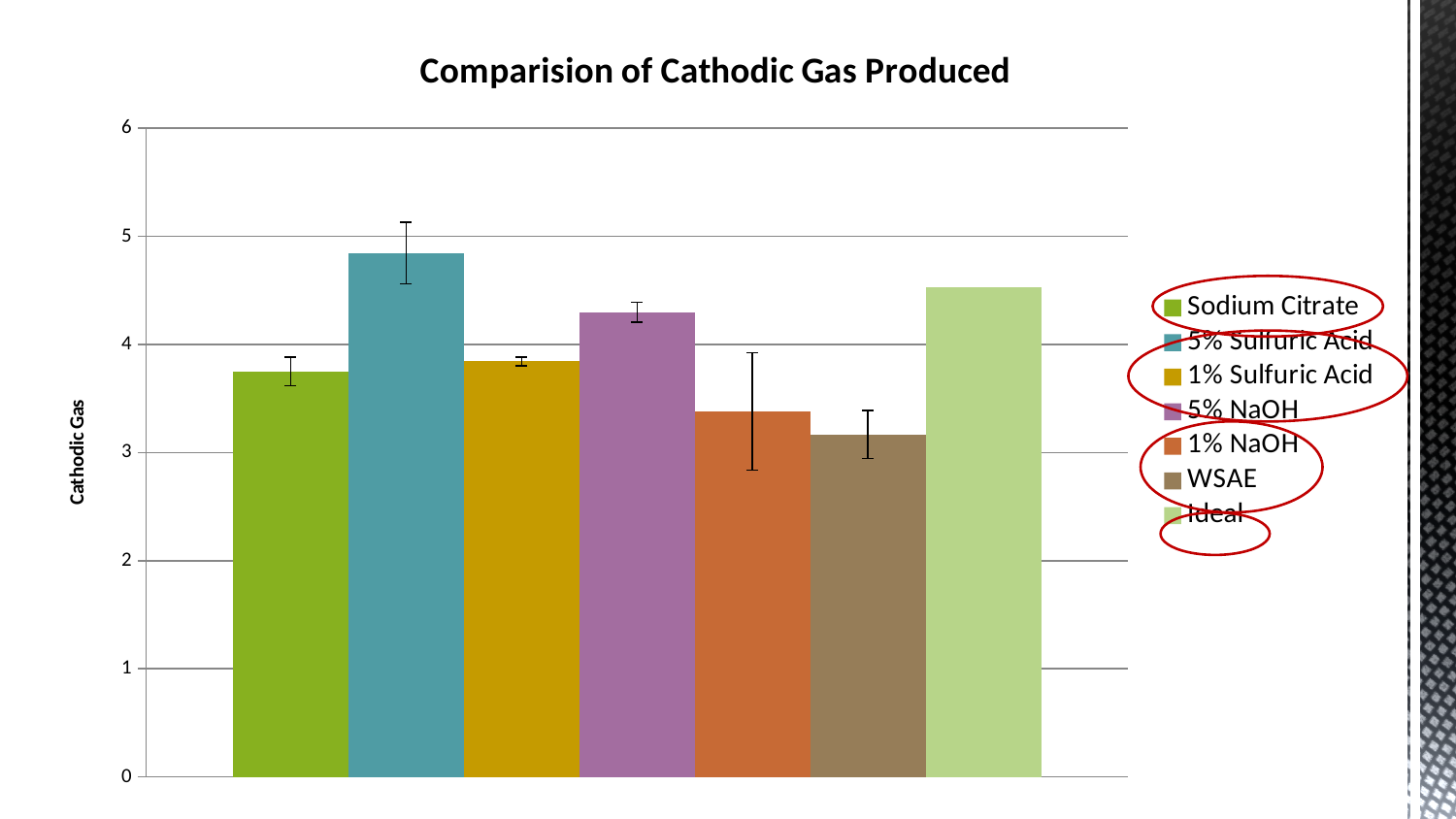
Is the value for 5% Sulfuric Acid greater or less than 4? greater How many series does the legend list? 7 Is the value for 1% NaOH greater or less than 4? less Is the value for Ideal greater or less than 5? less Which is larger, the value for 5% NaOH or the value for 1% NaOH? 5% NaOH What kind of chart is shown on the slide? bar chart What is the label on the vertical axis? Cathodic Gas Which series has the highest cathodic gas value? 5% Sulfuric Acid Which is larger, the value for Ideal or the value for Sodium Citrate? Ideal What is the title of the chart? Comparision of Cathodic Gas Produced Which series has the lowest cathodic gas value? WSAE